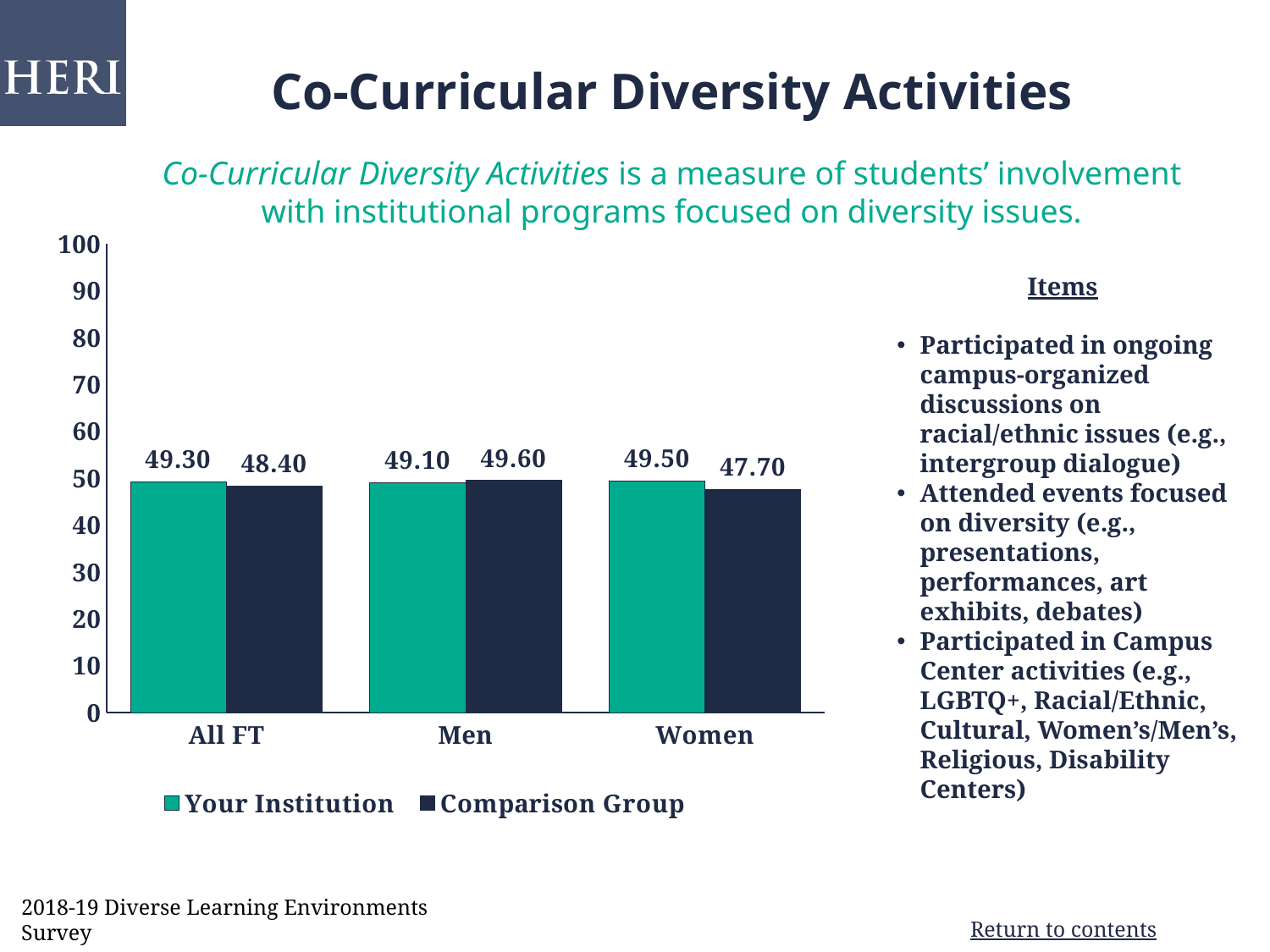
What is the value for Your Institution in the Women category? 49.50 In the Men category, which is larger: Your Institution or the Comparison Group? Comparison Group Which category has the highest Comparison Group value? Men What is the difference between Your Institution and the Comparison Group in the Women category? 1.80 How many series does the legend list? 2 Is the value for the Comparison Group in the All FT category greater or less than 50? less What is the value for the Comparison Group in the Men category? 49.60 What is the value for the Comparison Group in the Women category? 47.70 Which category has the lowest Comparison Group value? Women What is the value for Your Institution in the All FT category? 49.30 What kind of chart is shown on the slide? bar chart How many categories are shown on the x axis? 3